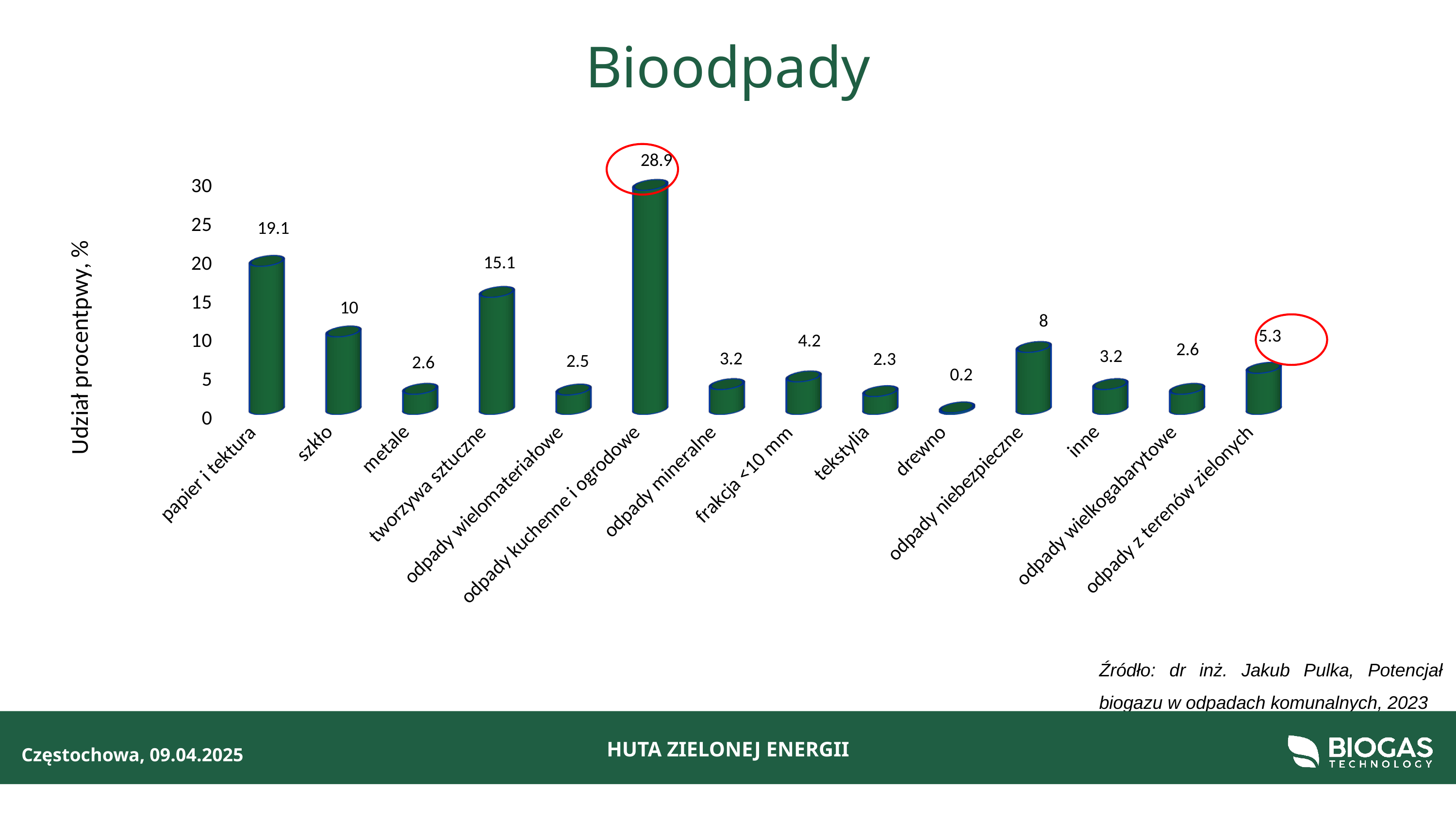
Which is larger, the value for frakcja <10 mm or the value for tekstylia? frakcja <10 mm What is the value for odpady z terenów zielonych? 5.3 How many categories are shown on the x axis? 14 Which category has the highest value? odpady kuchenne i ogrodowe What kind of chart is shown on the slide? bar chart What is the difference between the values for papier i tektura and tworzywa sztuczne? 4 What is the value for odpady kuchenne i ogrodowe? 28.9 What is the difference between the values for odpady kuchenne i ogrodowe and szkło? 18.9 What is the label of the vertical axis? Udział procentpwy, % What is the value for papier i tektura? 19.1 Which category has the lowest value? drewno What is the value for odpady niebezpieczne? 8